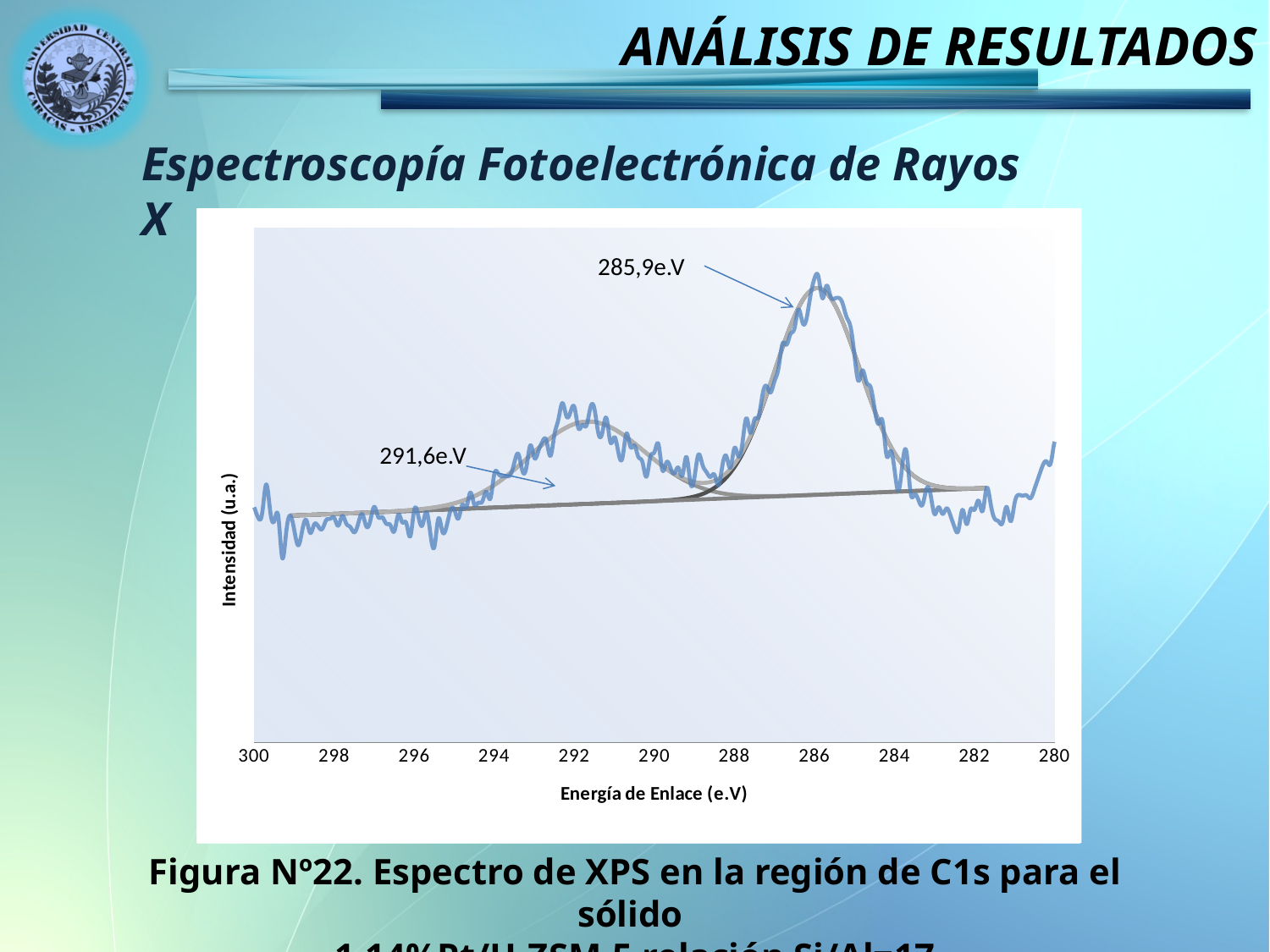
At what binding energy is the taller peak annotated in the chart? 285,9e.V How many tick labels are shown on the x axis of the chart? 11 What is the label of the y axis of the chart? Intensidad (u.a.) At what binding energy is the smaller peak annotated in the chart? 291,6e.V What kind of chart is shown on the slide? Line chart Is the binding energy of the smaller peak greater or less than 290 e.V? greater What are the minimum and maximum values shown on the x axis of the chart? 280 and 300 Is the binding energy of the taller peak greater or less than 288 e.V? less Which annotated peak has the lowest intensity? 291,6e.V What is the label of the x axis of the chart? Energía de Enlace (e.V) Which annotated peak has the higher intensity, the one at 285,9e.V or the one at 291,6e.V? 285,9e.V How many peaks are annotated with a binding energy value in the chart? 2